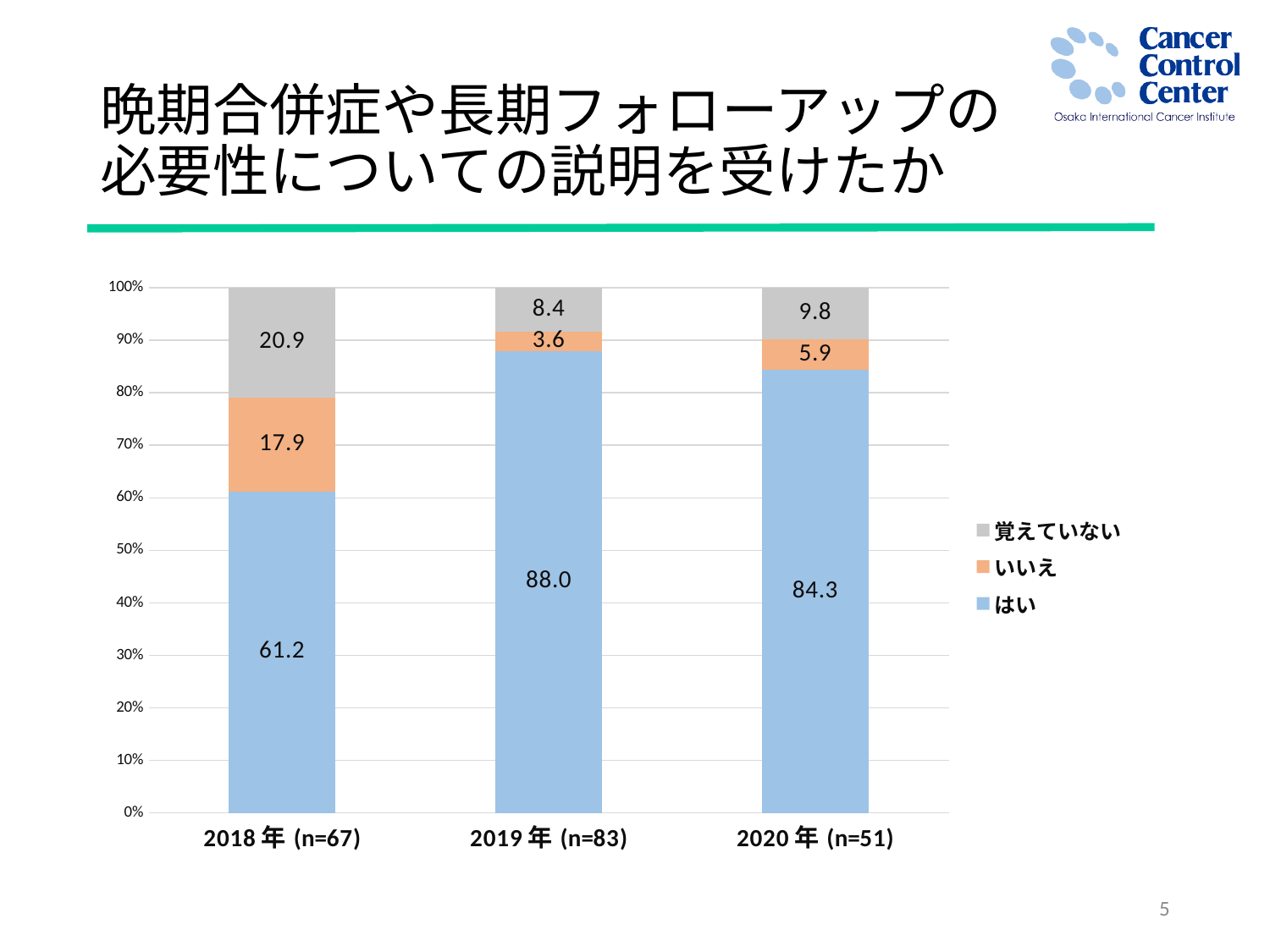
How many series does the legend list? 3 Which is larger: the 覚えていない value for 2018年 (n=67) or for 2020年 (n=51)? 2018年 (n=67) Does the value for いいえ rise or fall from 2018年 to 2019年? Fall What is the value for 覚えていない in 2020年 (n=51)? 9.8 What kind of chart is shown on the slide? Stacked bar chart Which year has the lowest value for いいえ? 2019年 (n=83) What is the difference between the はい values for 2019年 (n=83) and 2018年 (n=67)? 26.8 How many year categories are shown on the x axis? 3 Which year has the highest value for はい? 2019年 (n=83) What is the value for はい in 2018年 (n=67)? 61.2 What is the value for いいえ in 2019年 (n=83)? 3.6 Which colour represents はい in the legend? Blue